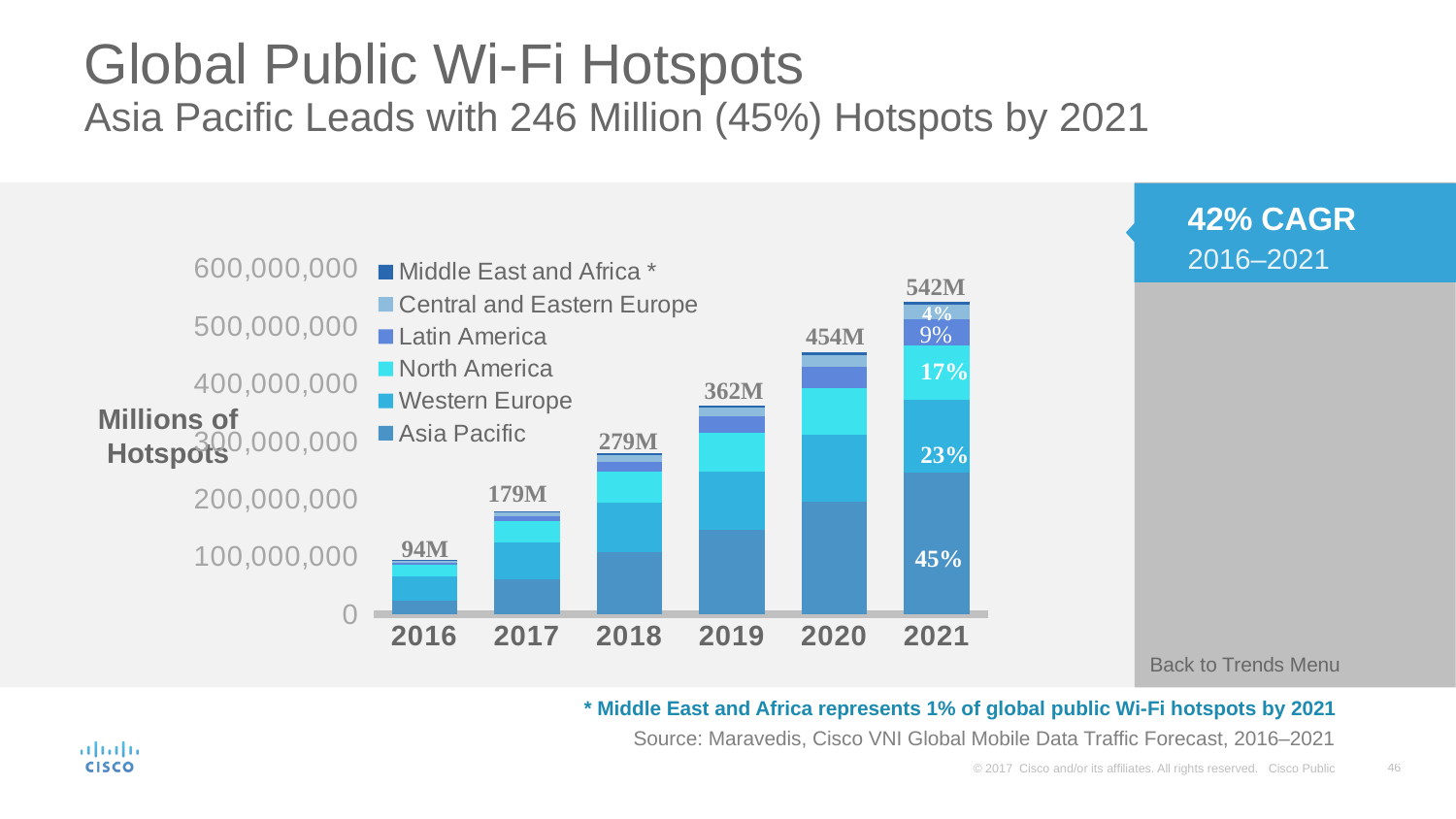
Do the total hotspot values rise or fall from 2016 to 2021? Rise Which year has a larger total of hotspots, 2017 or 2019? 2019 Is the Asia Pacific segment of the 2021 bar greater or less than 200,000,000? greater How many years are shown on the x axis? 6 Which year has the lowest total number of hotspots? 2016 How many series does the legend list? 6 What is the total number of global public Wi-Fi hotspots shown for 2021? 542M What is the difference between the total hotspots in 2021 and 2020? 88M Which year has the highest total number of hotspots? 2021 What is the total number of global public Wi-Fi hotspots shown for 2018? 279M What share of the 2021 hotspots does Western Europe represent? 23% What type of chart is shown on the slide? Stacked bar chart